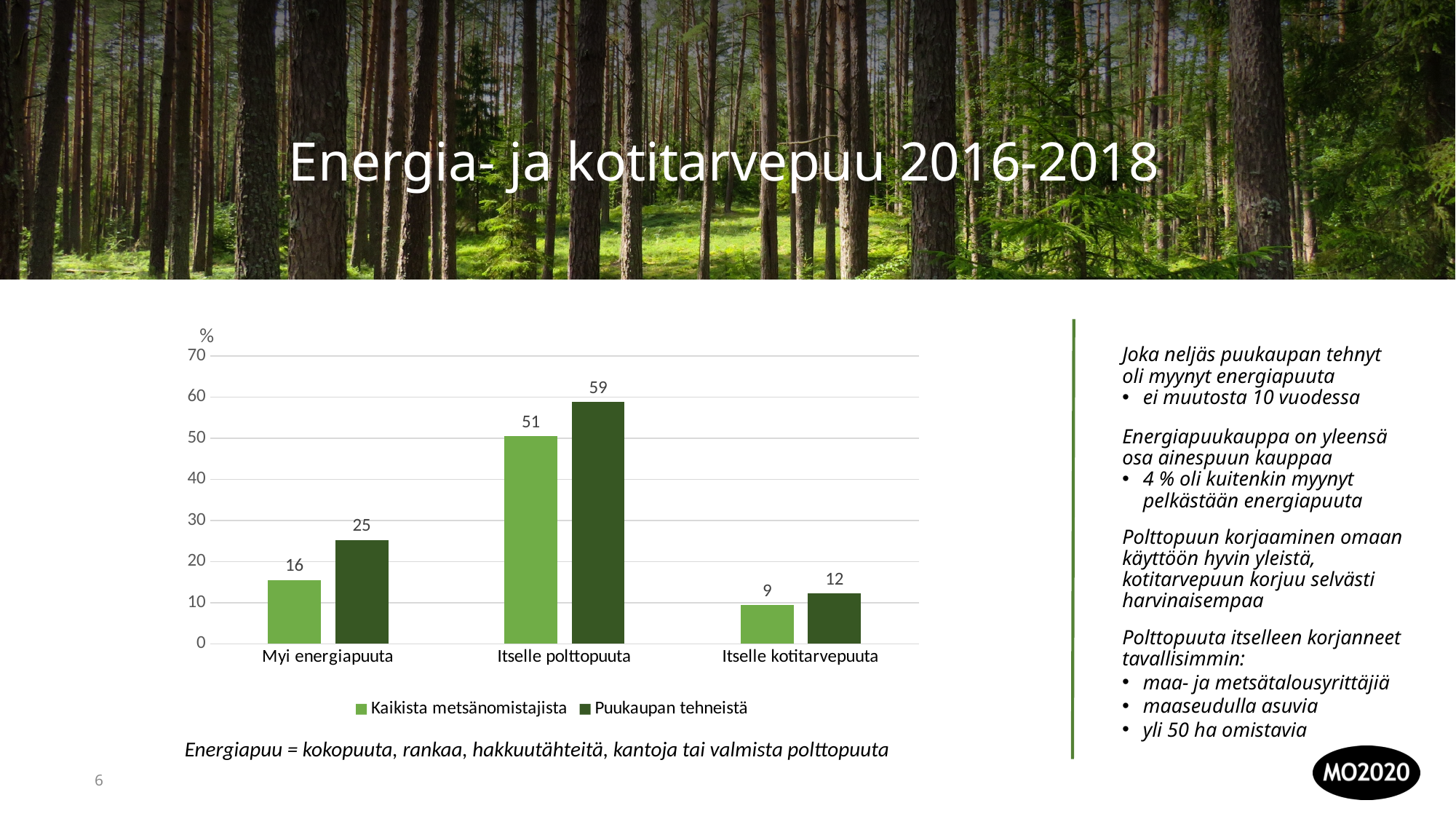
Which category has the highest value for the 'Puukaupan tehneistä' series? Itselle polttopuuta How many series does the chart legend list? 2 Which category has the lowest value for the 'Kaikista metsänomistajista' series? Itselle kotitarvepuuta What is the difference between the 'Puukaupan tehneistä' and 'Kaikista metsänomistajista' values in the 'Myi energiapuuta' category? 9 Is the 'Puukaupan tehneistä' value for 'Itselle polttopuuta' greater or less than 50? greater What is the value for 'Kaikista metsänomistajista' in the 'Itselle kotitarvepuuta' category? 9 Which is larger: the 'Kaikista metsänomistajista' value for 'Myi energiapuuta' or for 'Itselle kotitarvepuuta'? Myi energiapuuta What is the difference between the 'Puukaupan tehneistä' and 'Kaikista metsänomistajista' values in the 'Itselle polttopuuta' category? 8 What kind of chart is shown on the slide? Bar chart What is the value for 'Puukaupan tehneistä' in the 'Myi energiapuuta' category? 25 What is the value for 'Kaikista metsänomistajista' in the 'Itselle polttopuuta' category? 51 How many categories are shown on the x axis of the chart? 3